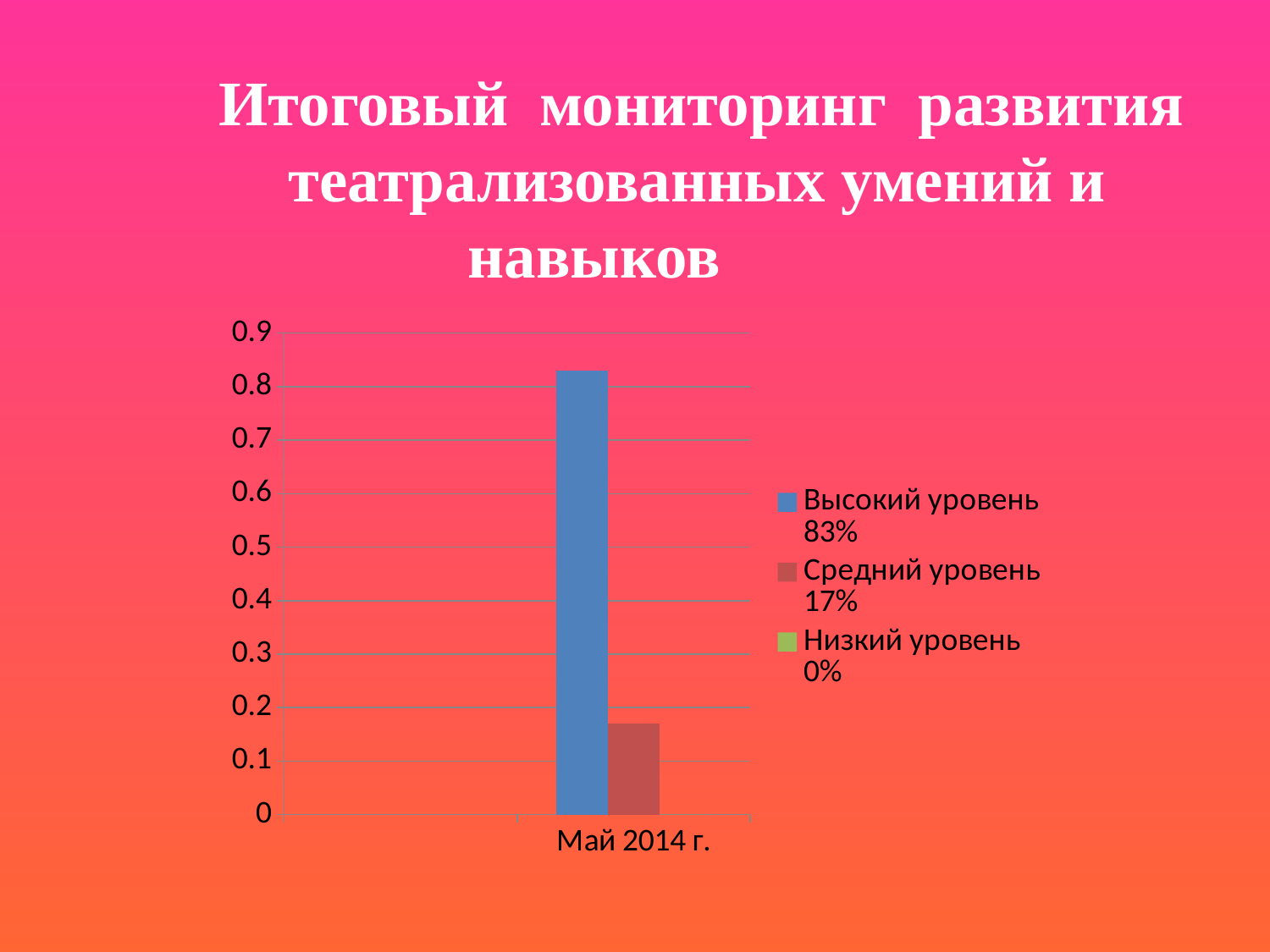
Is the bar for Высокий уровень greater or less than 0.5? greater What is the category label on the x axis? Май 2014 г. What value does the legend give for Высокий уровень? 83% What is the difference between Высокий уровень and Средний уровень? 66% How many categories are shown on the x axis? 1 How many series does the legend list? 3 What value does the legend give for Низкий уровень? 0% Which is larger, Высокий уровень or Средний уровень? Высокий уровень Which series has the lowest value? Низкий уровень Which series has the highest value? Высокий уровень What value does the legend give for Средний уровень? 17% What kind of chart is shown on the slide? bar chart